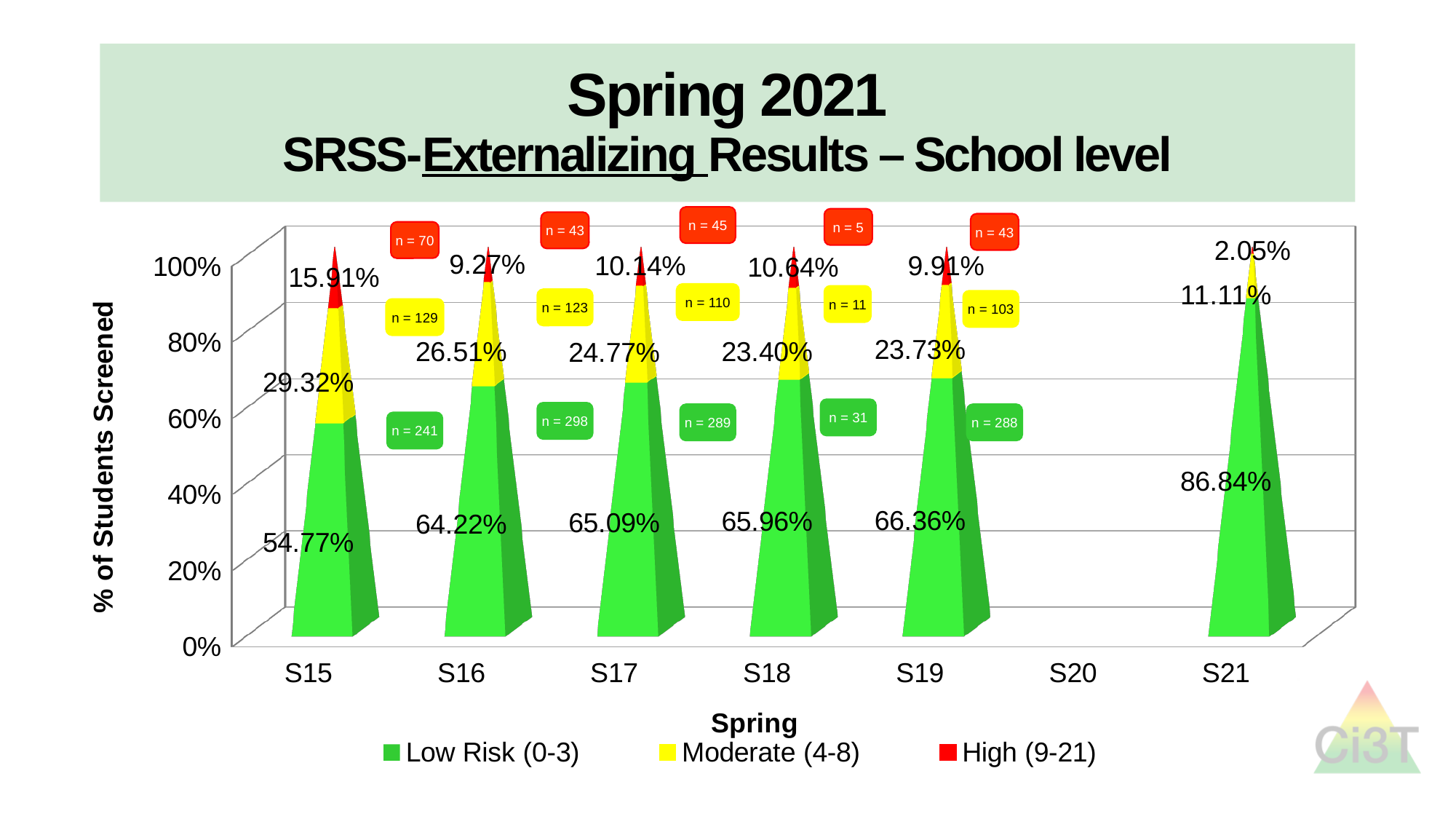
What kind of chart is shown on the slide? Stacked bar chart What is the Low Risk (0-3) percentage for S18? 65.96% What is the Low Risk (0-3) percentage for S21? 86.84% How many series does the legend list? 3 Which spring has the lowest High (9-21) percentage? S21 What is the Moderate (4-8) percentage for S17? 24.77% Is the Moderate (4-8) percentage larger for S16 or S19? S16 What is the difference between the Low Risk (0-3) percentages for S21 and S15? 32.07% What is the High (9-21) percentage for S15? 15.91% Which spring has the highest Moderate (4-8) percentage? S15 Which spring has the highest Low Risk (0-3) percentage? S21 Does the Low Risk (0-3) percentage rise or fall from S15 to S19? Rise